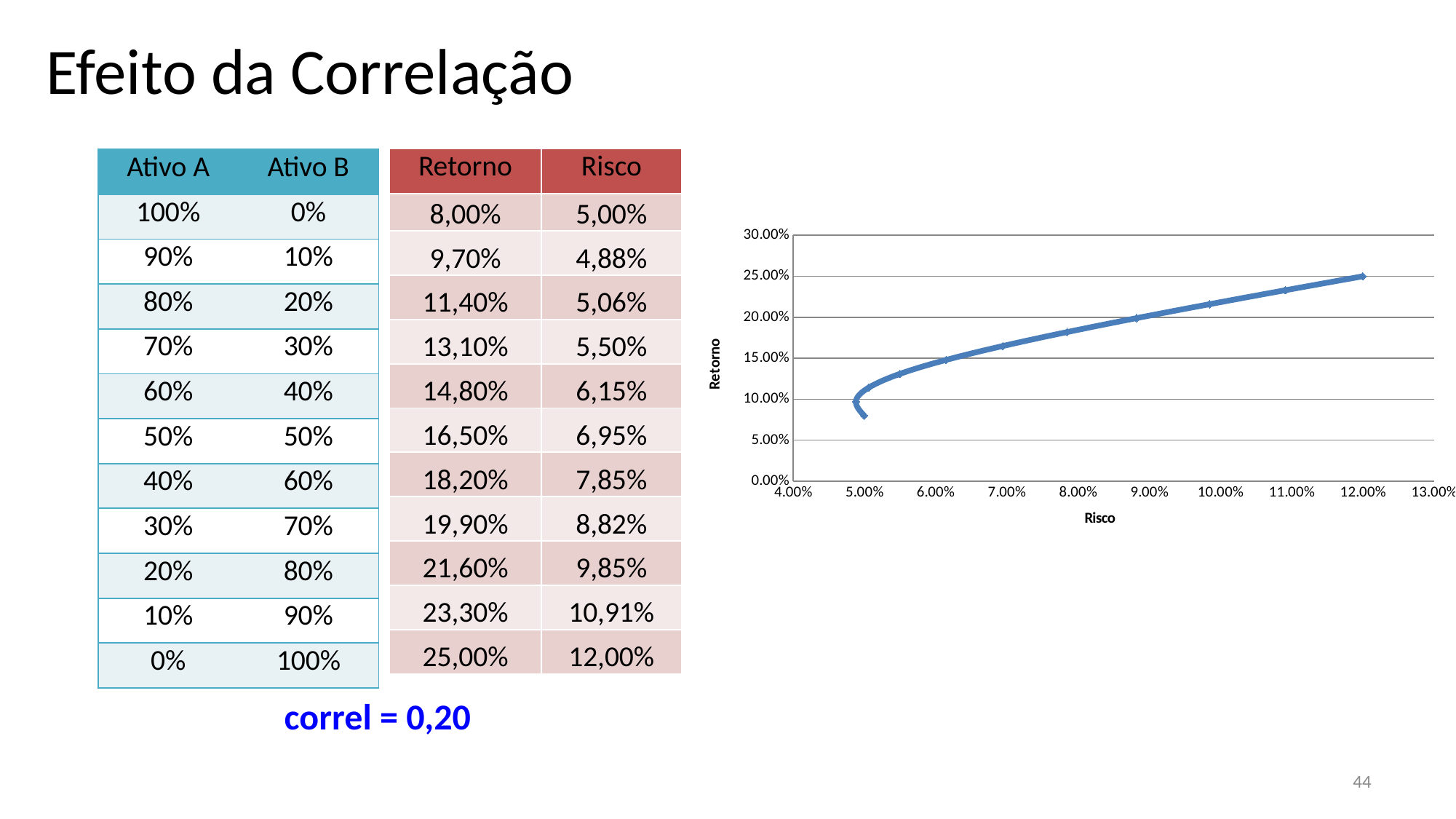
What is the maximum value shown on the y axis of the chart? 30.00% Is the Retorno value at a Risco of 10.00% greater or less than 25.00%? less Does Retorno generally rise or fall as Risco increases from 5.00% to 12.00% on the chart? rise Is the lowest Retorno value on the curve greater or less than 10.00%? less How many data points are plotted on the curve, according to the table on the slide? 11 What is the title of the y axis of the chart? Retorno Which is larger on the chart: the Retorno at a Risco of 6.00% or the Retorno at a Risco of 11.00%? Retorno at 11.00% Is the Retorno value at a Risco of 7.00% greater or less than 15.00%? greater What kind of chart is shown on the right of the slide? line chart What is the title of the x axis of the chart? Risco At what Risco value does the curve reach its highest Retorno? 12.00% What is the highest Retorno value reached by the curve on the chart? 25.00%